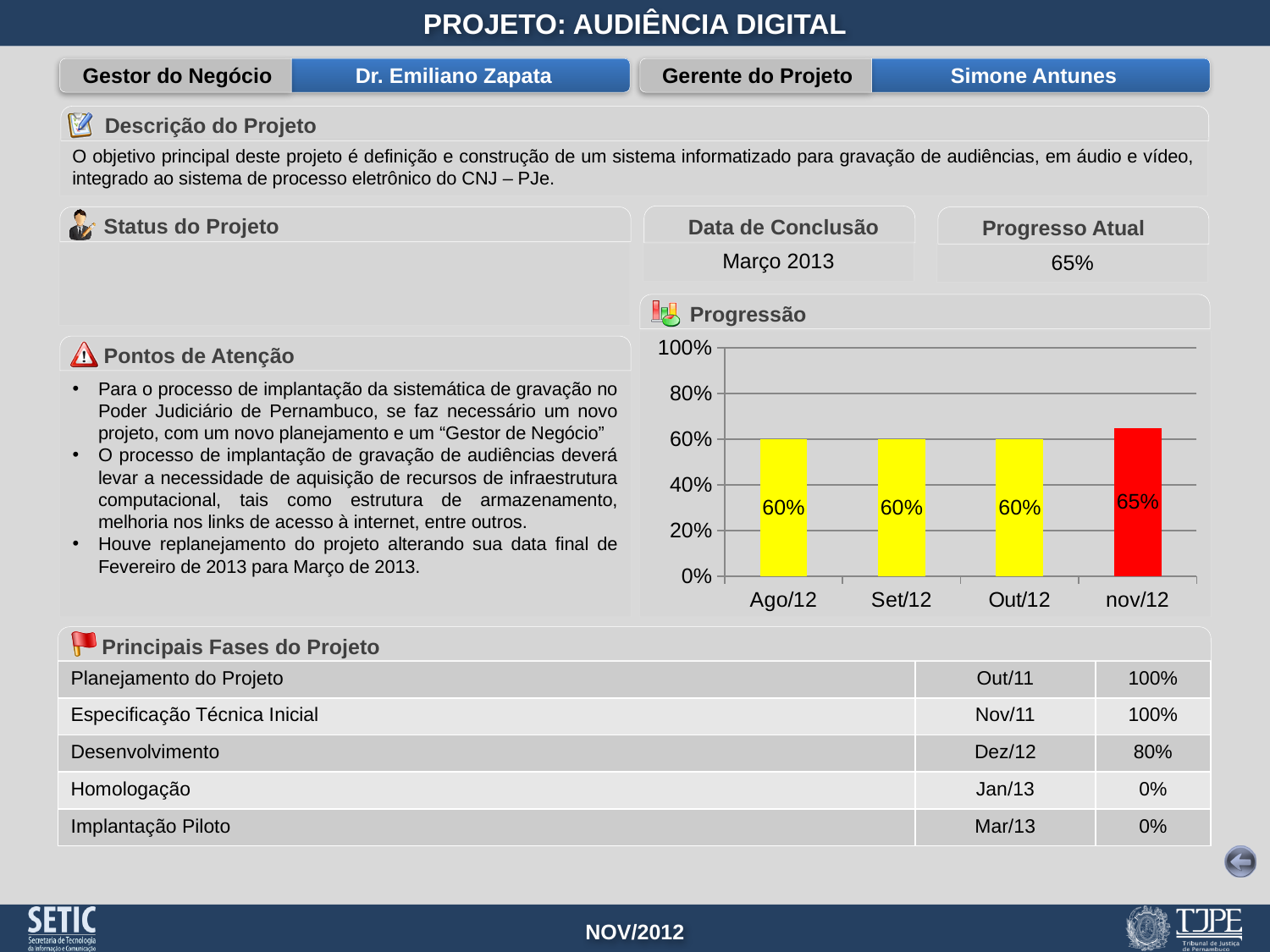
In the Progressão chart, which is larger: the value for Set/12 or the value for nov/12? nov/12 Is the value for nov/12 in the Progressão chart greater or less than 40%? greater What kind of chart is the Progressão chart? bar chart What is the value for nov/12 in the Progressão chart? 65% What is the value for Ago/12 in the Progressão chart? 60% What colour is the bar for nov/12 in the Progressão chart? red How many months are shown on the x axis of the Progressão chart? 4 Do the values in the Progressão chart rise or fall from Out/12 to nov/12? rise Which month has the highest value in the Progressão chart? nov/12 Is the value for Ago/12 in the Progressão chart greater or less than 80%? less What is the value for Out/12 in the Progressão chart? 60% What is the difference between the values for nov/12 and Out/12 in the Progressão chart? 5%